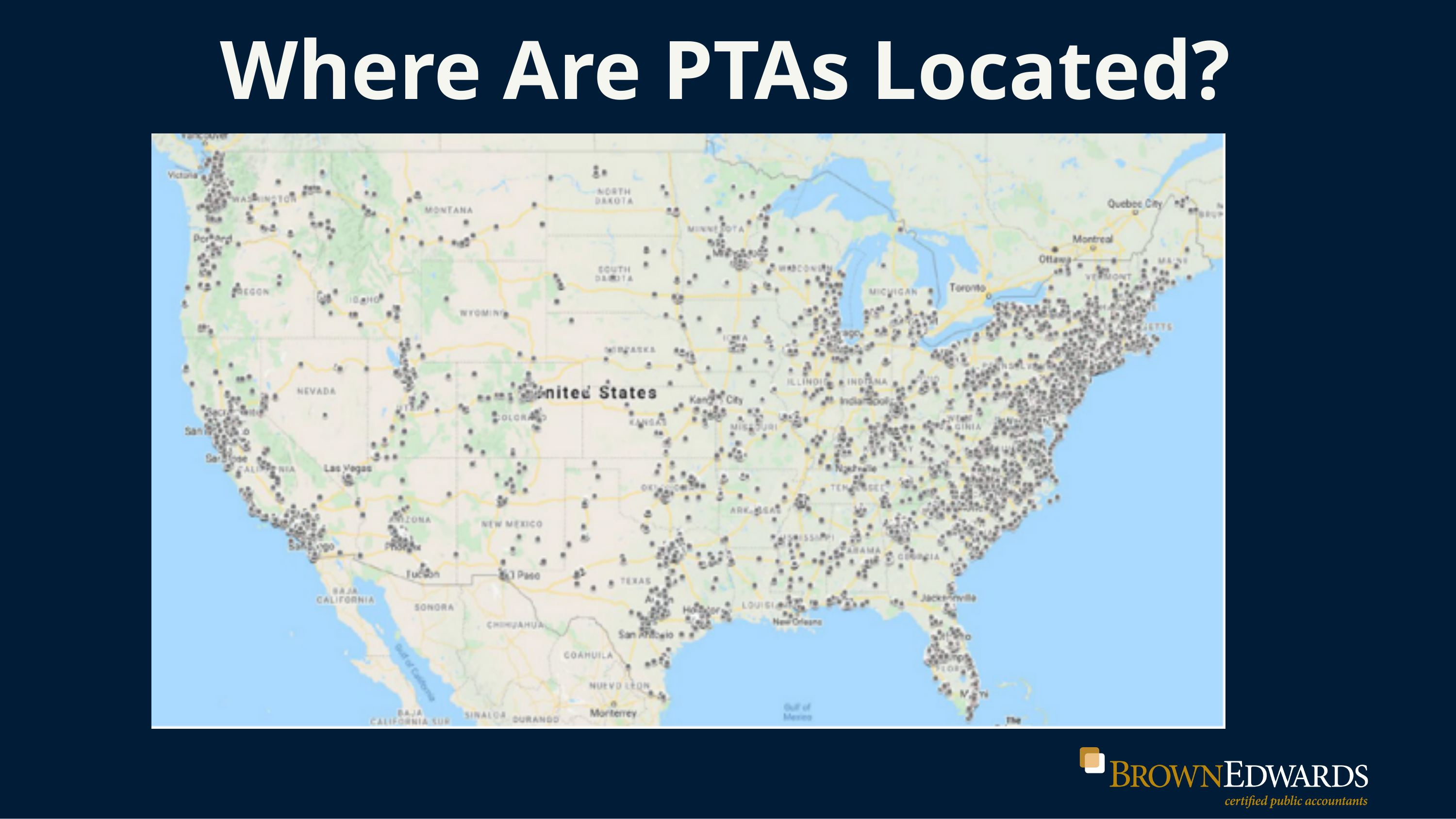
Which half of the United States, eastern or western, shows a denser concentration of dots on the map? Eastern What kind of visualization is used on the slide to show where PTAs are located? A dot map Which country is labeled at the center of the map? United States What is the title of the slide containing the map? Where Are PTAs Located?